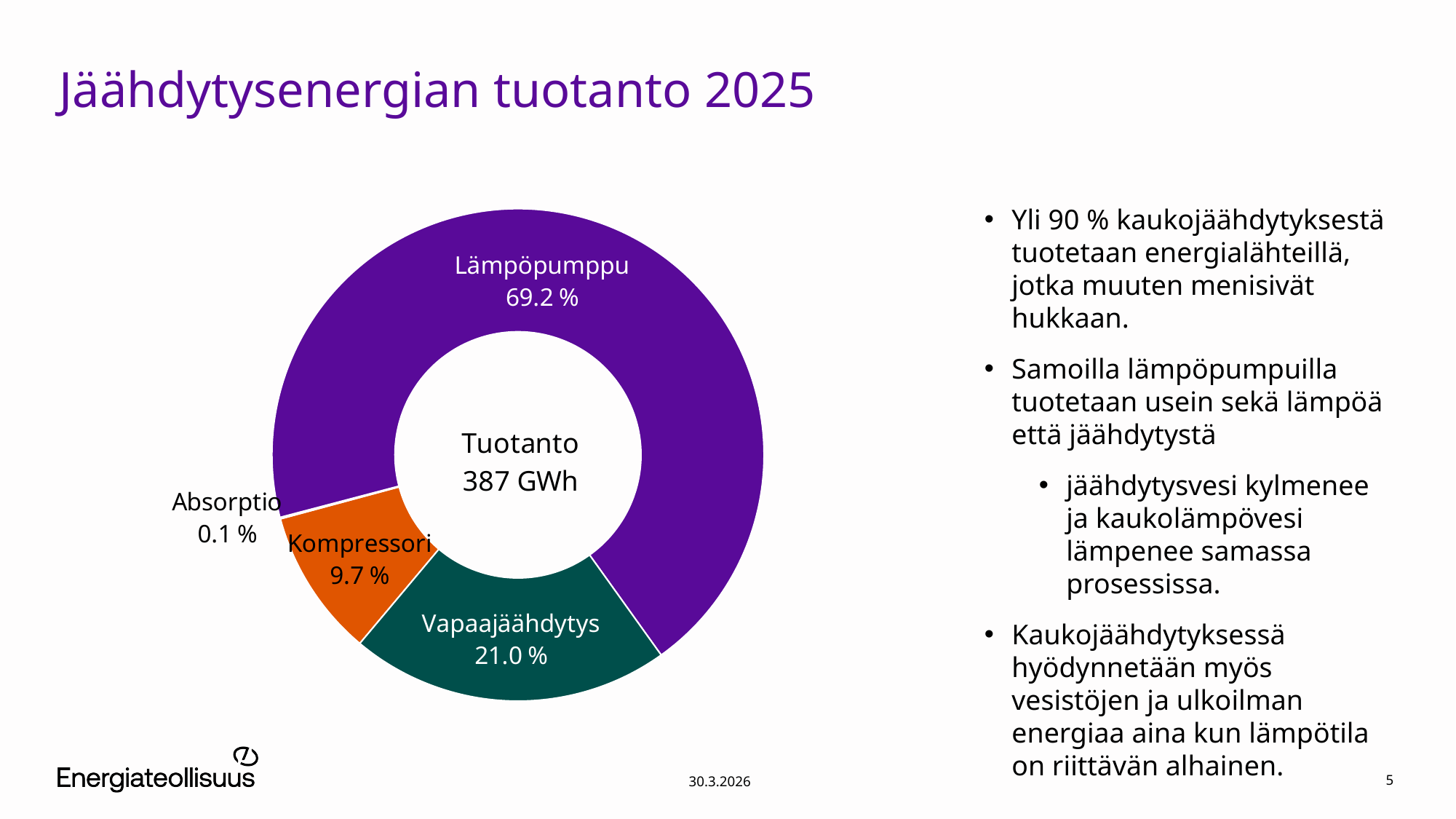
What kind of chart is shown on the slide? Doughnut chart How many categories are shown in the chart? 4 What colour is the Vapaajäähdytys segment? Dark green What total production is shown in the centre of the chart? 387 GWh Which is larger, Kompressori or Vapaajäähdytys? Vapaajäähdytys What is the value shown for Kompressori? 9.7 % What share of the chart does Vapaajäähdytys account for? 21.0 % What is the value shown for Absorptio? 0.1 % What is the difference in percentage points between Lämpöpumppu and Vapaajäähdytys? 48.2 Which category has the smallest share? Absorptio Which category has the largest share? Lämpöpumppu What share of the chart does Lämpöpumppu account for? 69.2 %